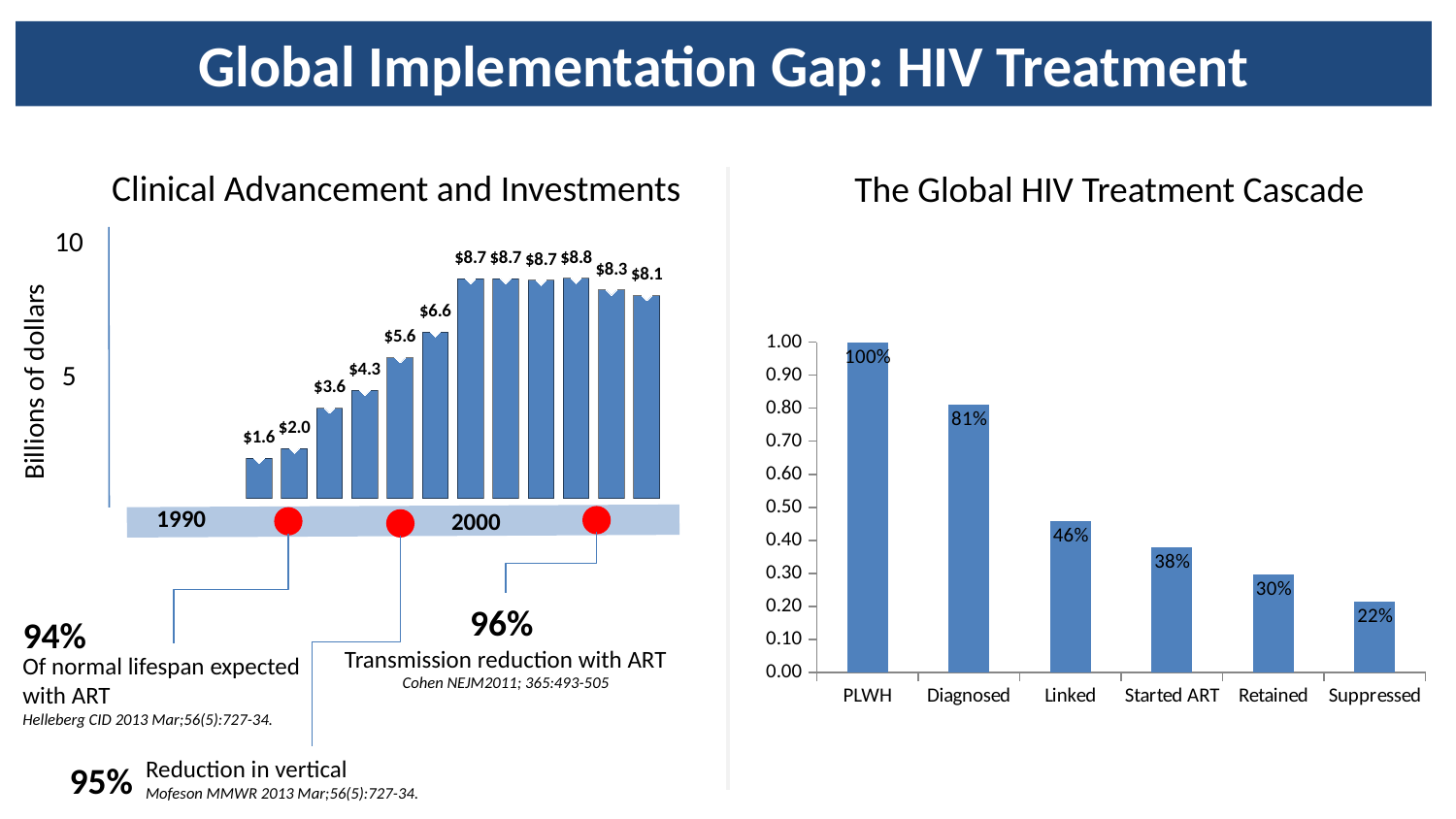
In the chart titled 'The Global HIV Treatment Cascade', which category has the lowest value? Suppressed In the chart titled 'The Global HIV Treatment Cascade', which is larger, the value for Retained or the value for Suppressed? Retained In the chart titled 'Clinical Advancement and Investments', what is the label on the vertical axis? Billions of dollars In the chart titled 'Clinical Advancement and Investments', what is the highest value labelled on a bar? $8.8 In the chart titled 'The Global HIV Treatment Cascade', what is the value for Diagnosed? 81% In the chart titled 'Clinical Advancement and Investments', what is the lowest value labelled on a bar? $1.6 In the chart titled 'The Global HIV Treatment Cascade', how many categories are shown on the x axis? 6 In the chart titled 'The Global HIV Treatment Cascade', what is the difference between the values for Diagnosed and Linked? 35% What kind of chart is the chart titled 'Clinical Advancement and Investments'? bar chart In the chart titled 'The Global HIV Treatment Cascade', do the values rise or fall from left to right along the x axis? fall In the chart titled 'The Global HIV Treatment Cascade', what is the value for Started ART? 38% In the chart titled 'Clinical Advancement and Investments', how many bars are plotted? 12